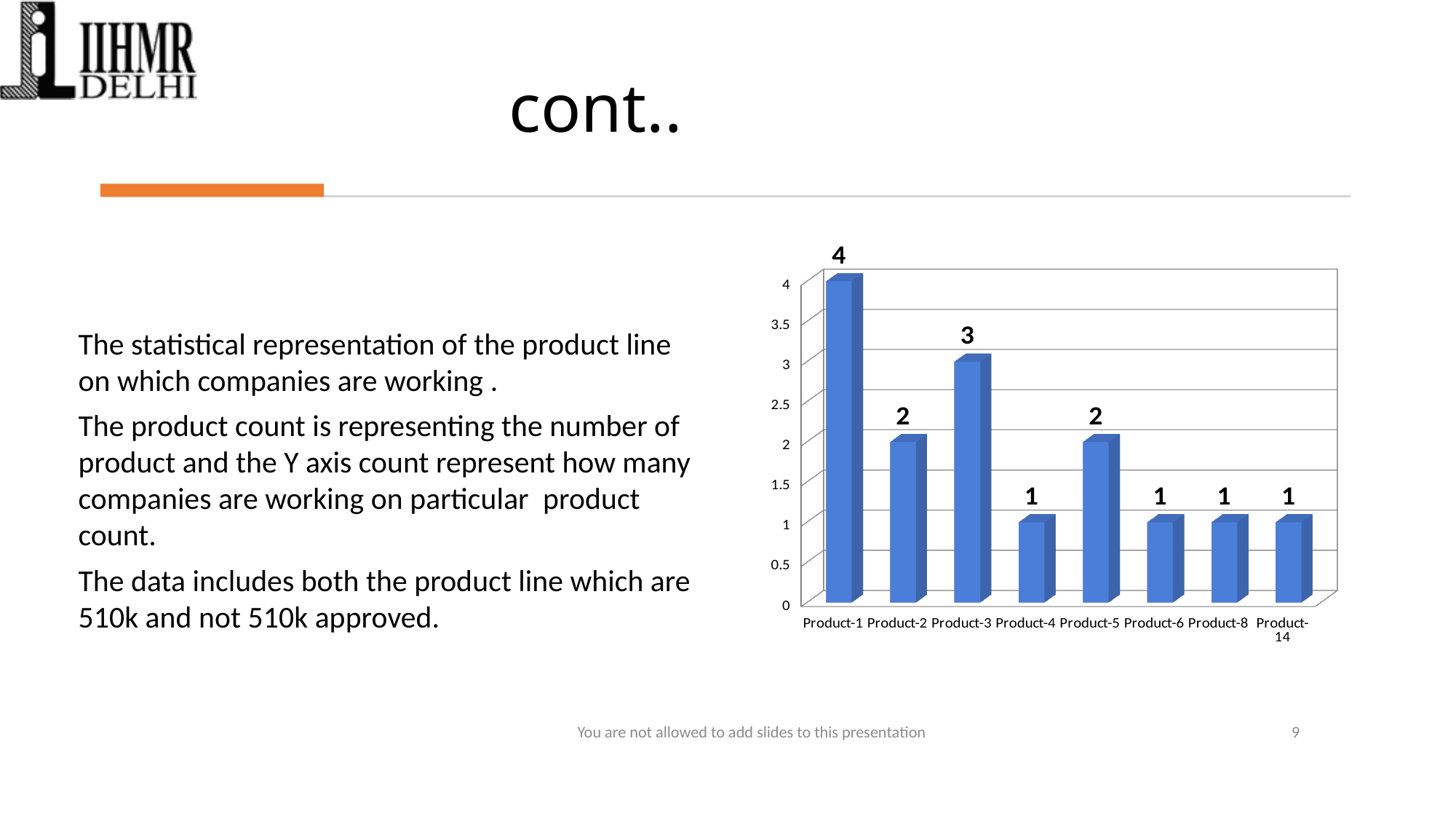
What is the value for Product-1? 4 Which category has the highest value? Product-1 Is the value for Product-3 greater or less than 2.5? greater What is the value for Product-14? 1 Which is larger, the value for Product-2 or the value for Product-6? Product-2 How many categories have a value of 1? 4 What is the value for Product-3? 3 What kind of chart is shown on the slide? bar chart What is the value for Product-5? 2 What is the difference between the values for Product-3 and Product-4? 2 How many categories are shown on the x axis? 8 What is the difference between the values for Product-1 and Product-3? 1